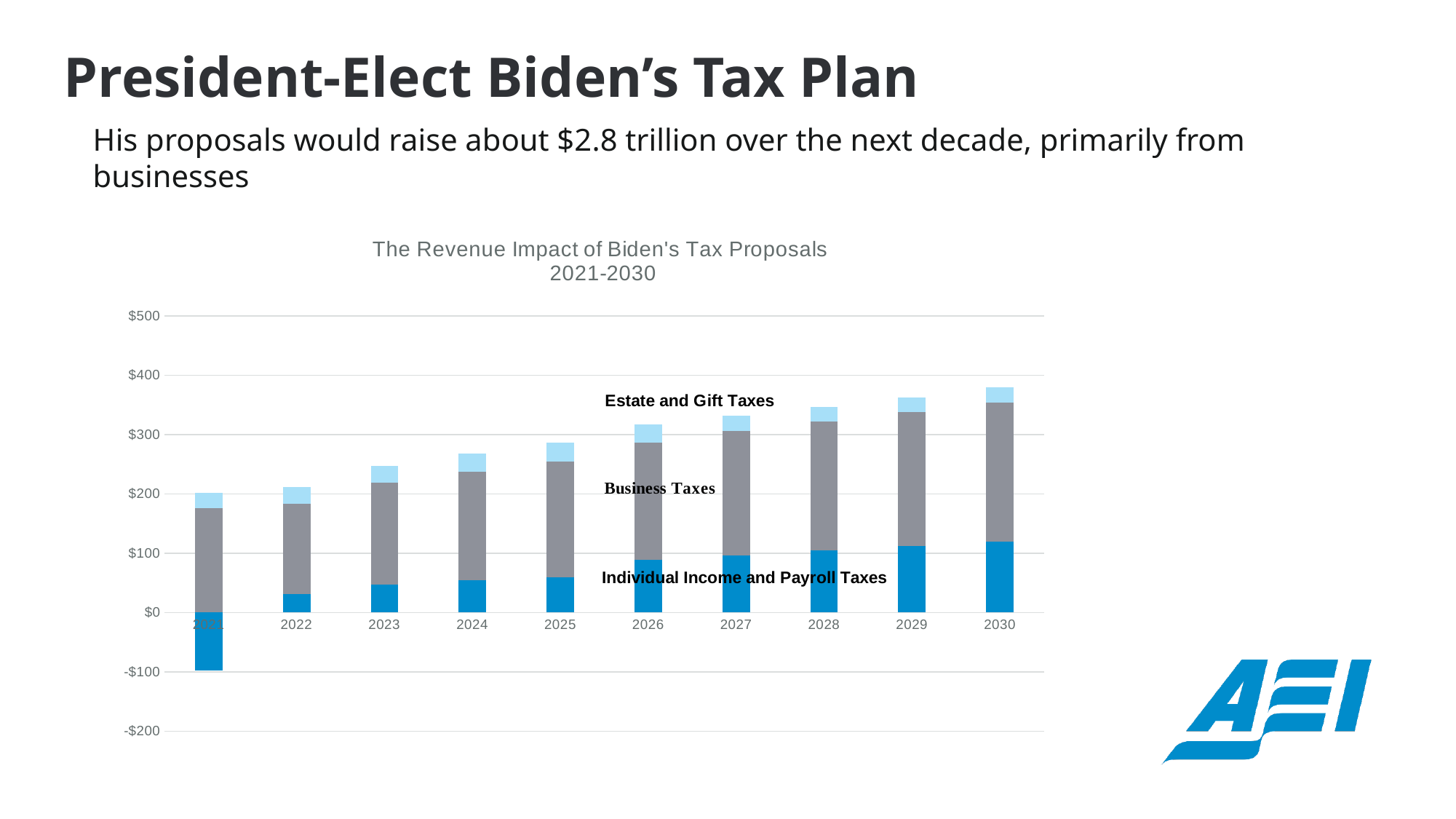
Is the total stacked bar for 2025 greater or less than $300? less Which tax category is shown in gray in the chart? Business Taxes Is the value for Individual Income and Payroll Taxes in 2021 greater or less than $0? less What kind of chart is shown on the slide? Stacked bar chart What is the title of the chart? The Revenue Impact of Biden's Tax Proposals 2021-2030 Do the total stacked bar heights rise or fall from 2021 to 2030? Rise Which year has the lowest total stacked bar in the chart? 2021 Is the total stacked bar for 2030 greater or less than $300? greater Which year has the tallest total stacked bar in the chart? 2030 Which year has a larger total stacked bar, 2022 or 2028? 2028 How many tax categories are stacked in each bar of the chart? 3 How many years are plotted on the x axis of the chart? 10